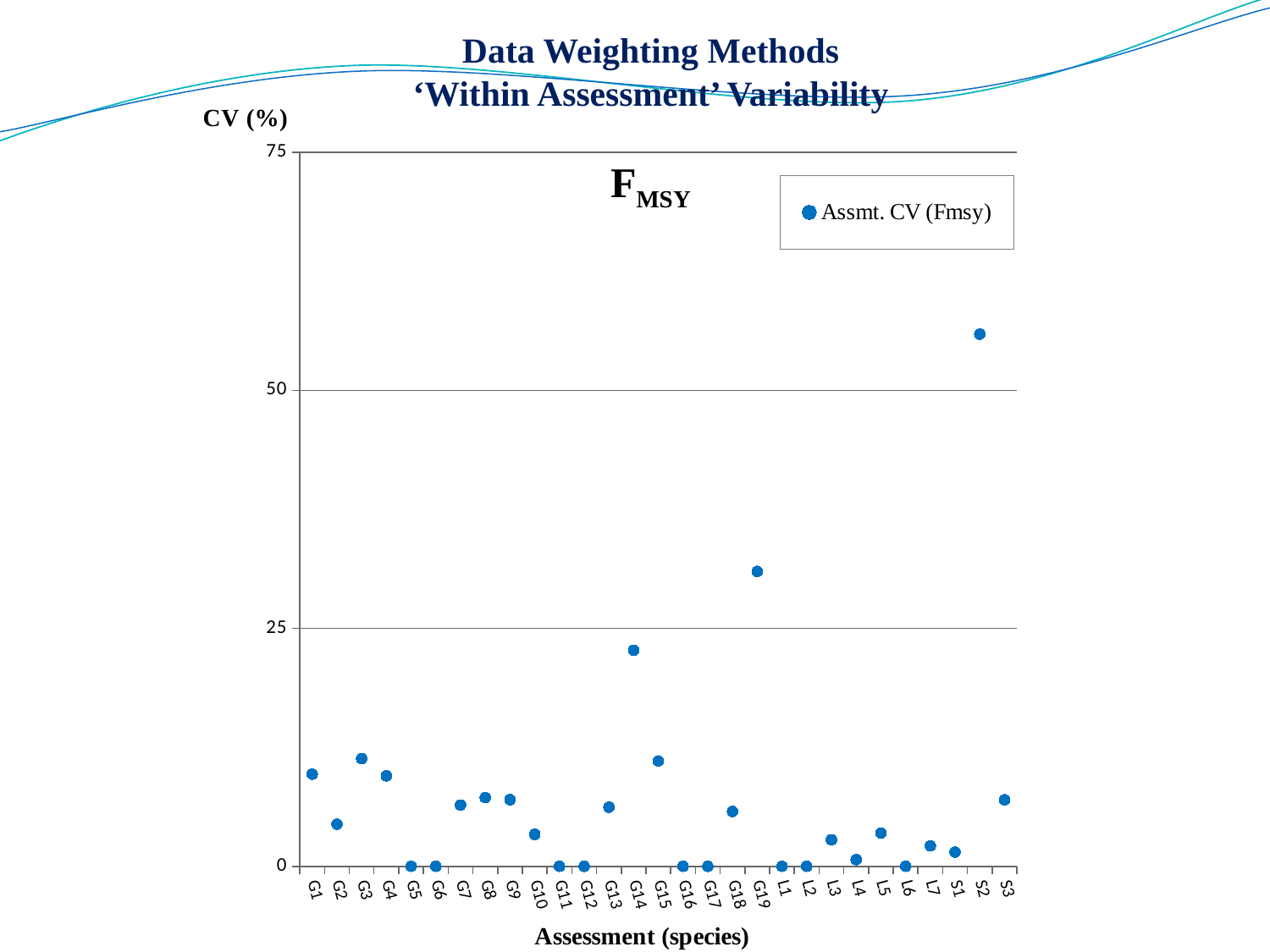
Is the value for S2 greater or less than 50? greater How many series does the legend list? 1 Is the value for G19 greater or less than 25? greater What is the label of the x axis? Assessment (species) What is the CV (%) value for G11? 0 Which assessment has the highest CV (%) value? S2 What is the CV (%) value for L6? 0 How many assessments (categories) are plotted along the x axis? 29 What is the legend entry for the plotted series? Assmt. CV (Fmsy) What kind of chart is shown on the slide? scatter chart Which is larger, the value for G19 or the value for G14? G19 Is the value for G14 greater or less than 25? less